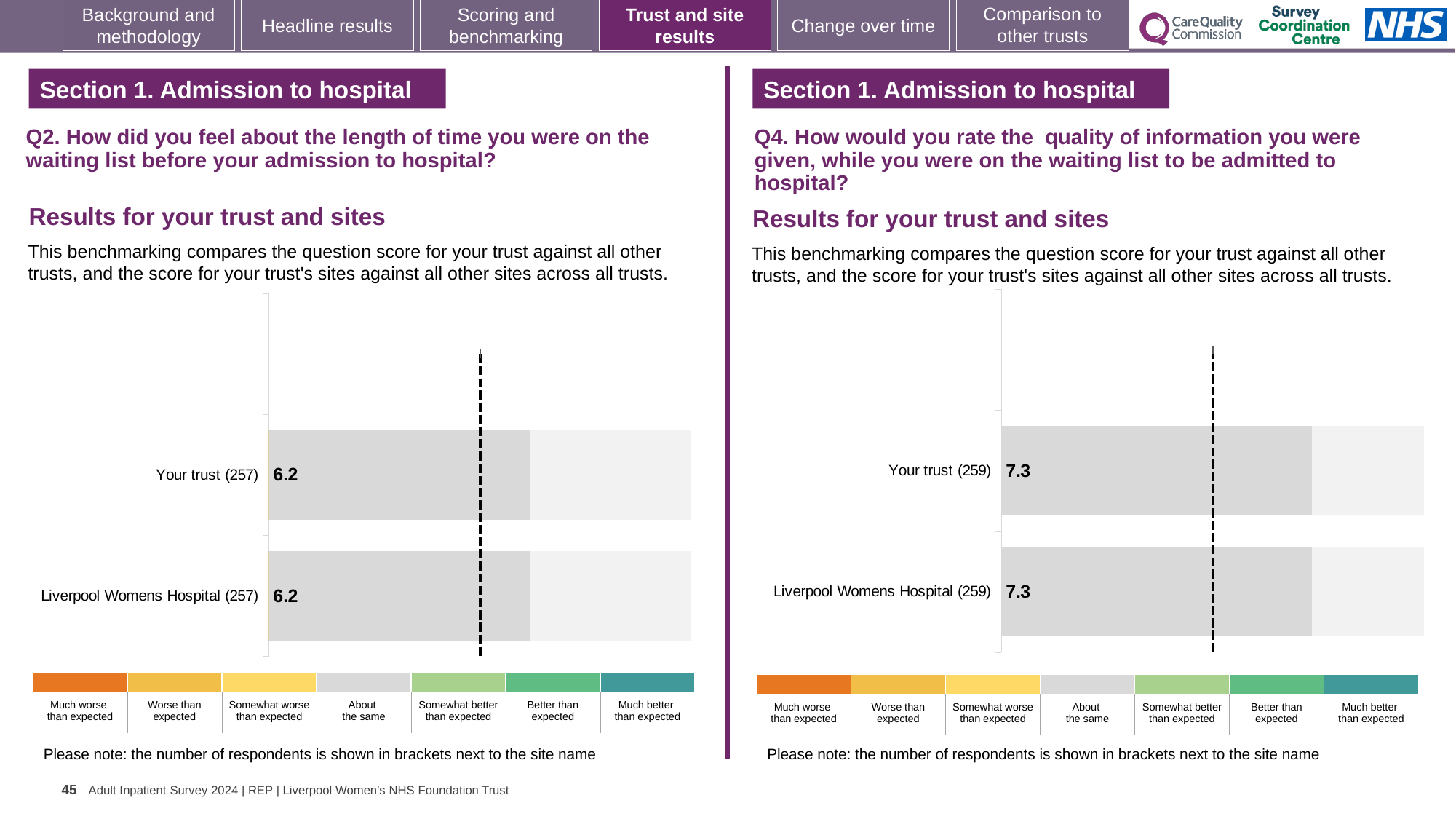
In the Q4 chart on the right, what is the score for Your trust? 7.3 How many bars are plotted in the Q2 chart on the left? 2 In the Q4 chart on the right, what is the difference between the score for Your trust and the score for Liverpool Womens Hospital? 0 What kind of chart is the Q2 chart on the left? Bar chart Is the score for Your trust in the Q4 chart on the right larger or smaller than the score for Your trust in the Q2 chart on the left? Larger How many bars are plotted in the Q4 chart on the right? 2 In the Q4 chart on the right, what is the score for Liverpool Womens Hospital? 7.3 In the Q2 chart on the left, what is the difference between the score for Your trust and the score for Liverpool Womens Hospital? 0 In the Q2 chart on the left, what is the score for Your trust? 6.2 In the Q2 chart on the left, what is the score for Liverpool Womens Hospital? 6.2 In the Q2 chart on the left, how many respondents are shown in brackets next to Your trust? 257 In the Q4 chart on the right, how many respondents are shown in brackets next to Liverpool Womens Hospital? 259